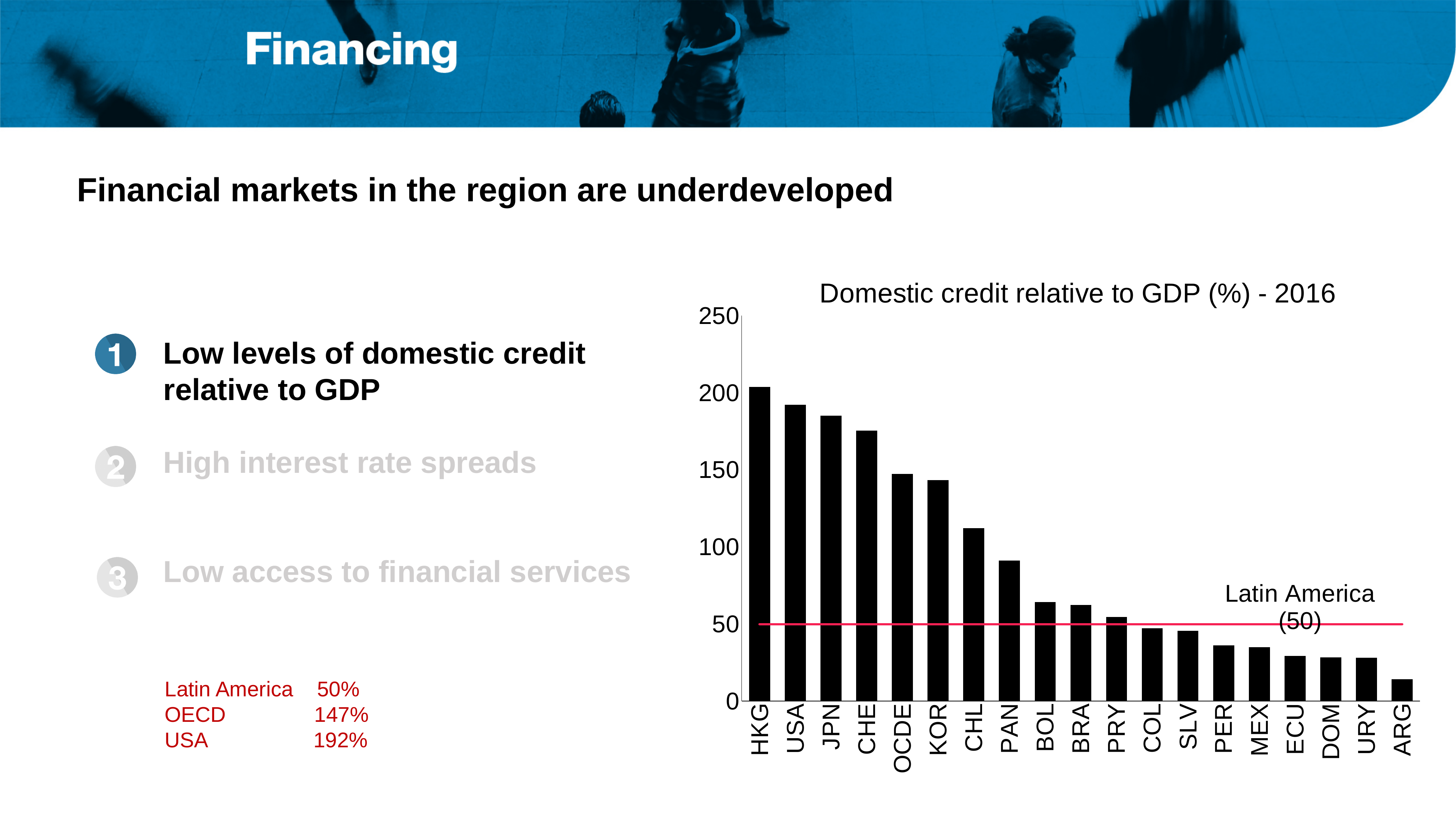
Is the value for CHL greater or less than 100? greater Which category has the highest domestic credit relative to GDP in the chart? HKG What value does the red horizontal line labelled Latin America mark on the chart? 50 How many countries or groups are shown on the x axis of the chart? 19 Which has a higher value, JPN or CHE? JPN Which category has the lowest domestic credit relative to GDP in the chart? ARG Is the value for ARG greater or less than 50? less According to the slide, what is the domestic credit relative to GDP for the USA? 192% What kind of chart is shown on the slide? bar chart What is the title of the chart? Domestic credit relative to GDP (%) - 2016 Is the value for HKG greater or less than 150? greater Do the bar values rise or fall moving from left to right along the x axis? fall